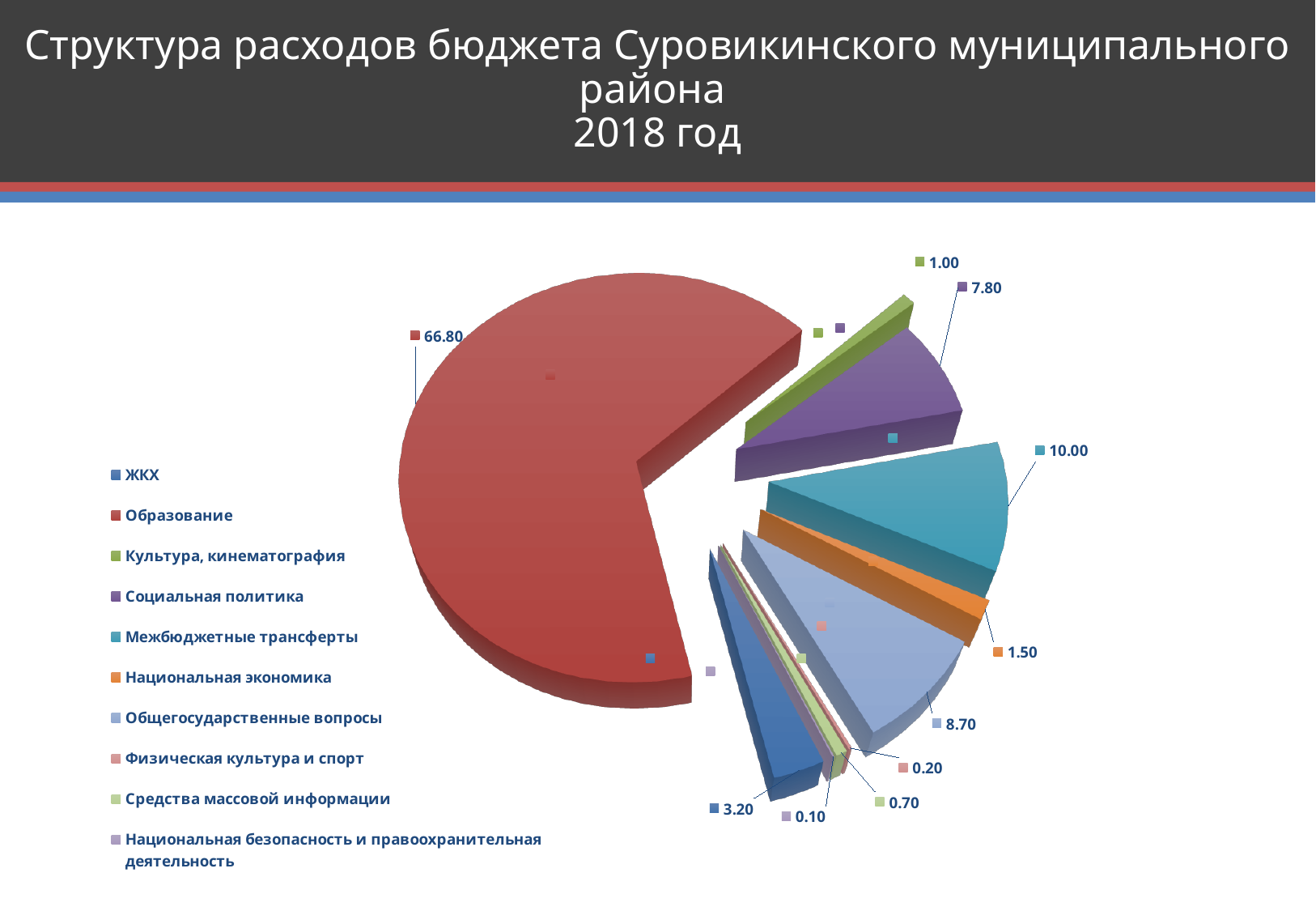
What is the value for Образование? 66.80 What is the value for ЖКХ? 3.20 Which category has the largest slice of the pie? Образование What is the difference between the values for Межбюджетные трансферты and Общегосударственные вопросы? 1.30 Which is larger, the value for Социальная политика or the value for Общегосударственные вопросы? Общегосударственные вопросы What colour is the slice for Национальная экономика? orange What type of chart is shown on the slide? pie chart Which category has the smallest slice of the pie? Национальная безопасность и правоохранительная деятельность What is the value for Межбюджетные трансферты? 10.00 How many categories does the legend list? 10 What is the value for Социальная политика? 7.80 What is the value for Национальная безопасность и правоохранительная деятельность? 0.10